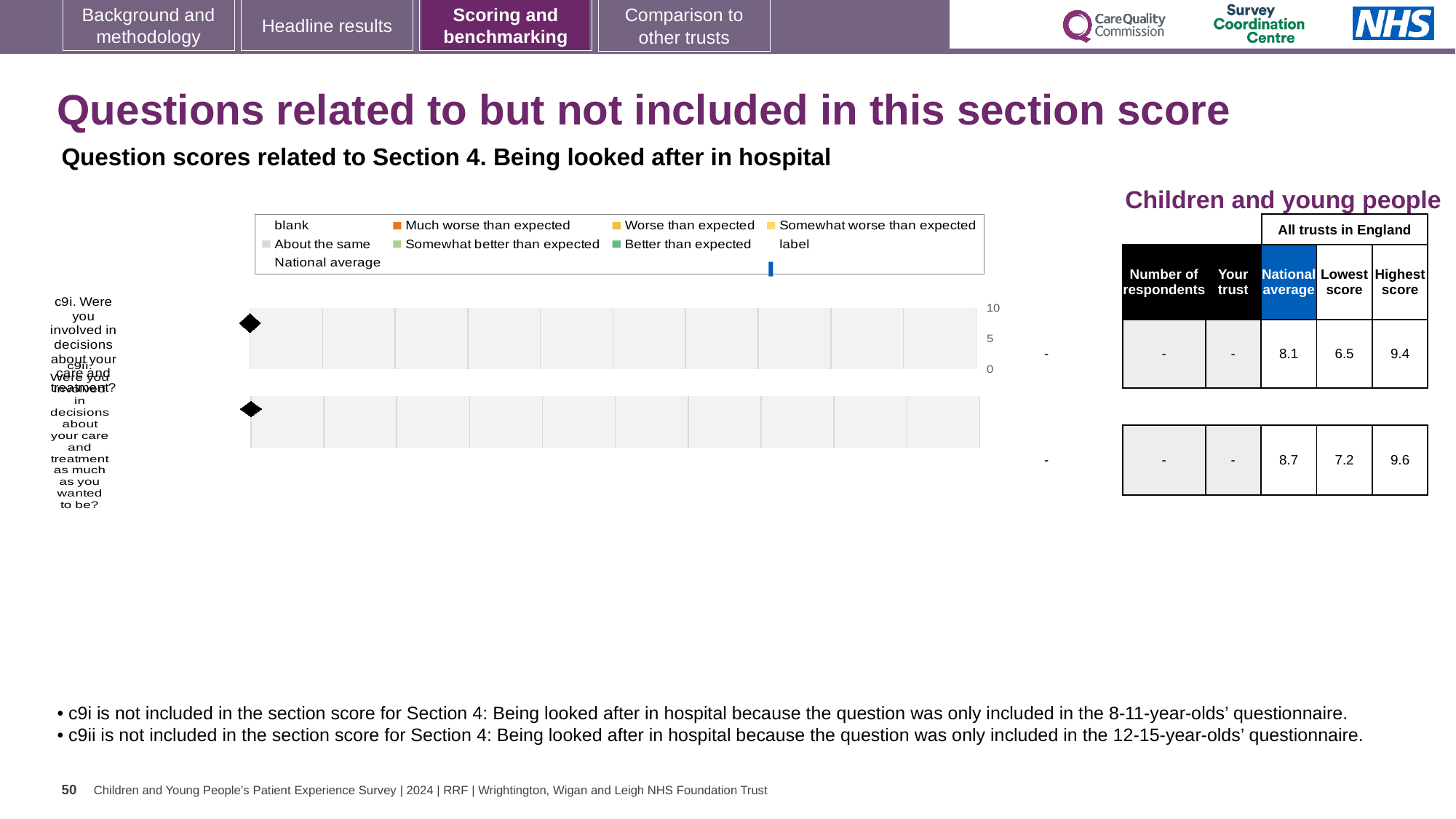
How many question categories (bars) does the chart show? 2 In the table beside the chart, what is the lowest score across all trusts in England for c9i? 6.5 In the table beside the chart, what is the difference between the national averages of c9ii and c9i? 0.6 In the table beside the chart, what is the highest score across all trusts in England for c9ii? 9.6 What is the highest tick value shown on the chart's axis? 10 In the table beside the chart, what is the difference between the highest and lowest scores for c9i? 2.9 In the table beside the chart, which question has the higher national average, c9i or c9ii? c9ii In the table beside the chart, what is the national average score for c9i? 8.1 Which legend entry is shown with an orange marker? Much worse than expected What kind of chart is shown on the slide? bar chart In the table beside the chart, what is the national average score for c9ii? 8.7